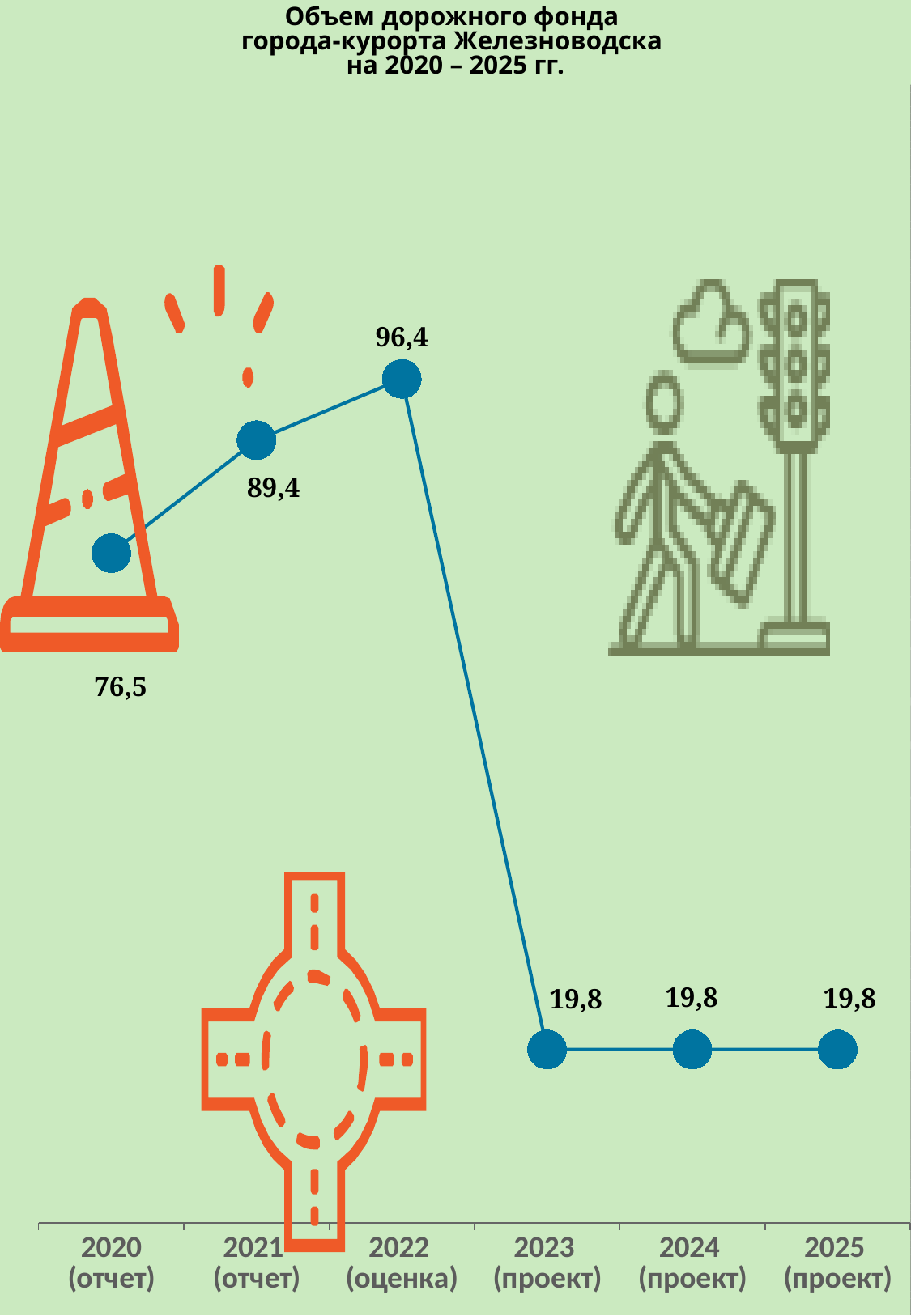
What is the value for 2022 (оценка)? 96,4 What is the value for 2020 (отчет)? 76,5 Which is larger, the value for 2020 (отчет) or the value for 2023 (проект)? 2020 (отчет) What is the value for 2024 (проект)? 19,8 What is the value for 2021 (отчет)? 89,4 What is the difference between the values for 2021 (отчет) and 2020 (отчет)? 12,9 How many data points are plotted on the chart? 6 What is the lowest value plotted on the chart? 19,8 What is the difference between the values for 2022 (оценка) and 2021 (отчет)? 7 Do the values rise or fall from 2020 to 2022? rise What kind of chart is shown on the slide? line chart Which year has the highest value? 2022 (оценка)